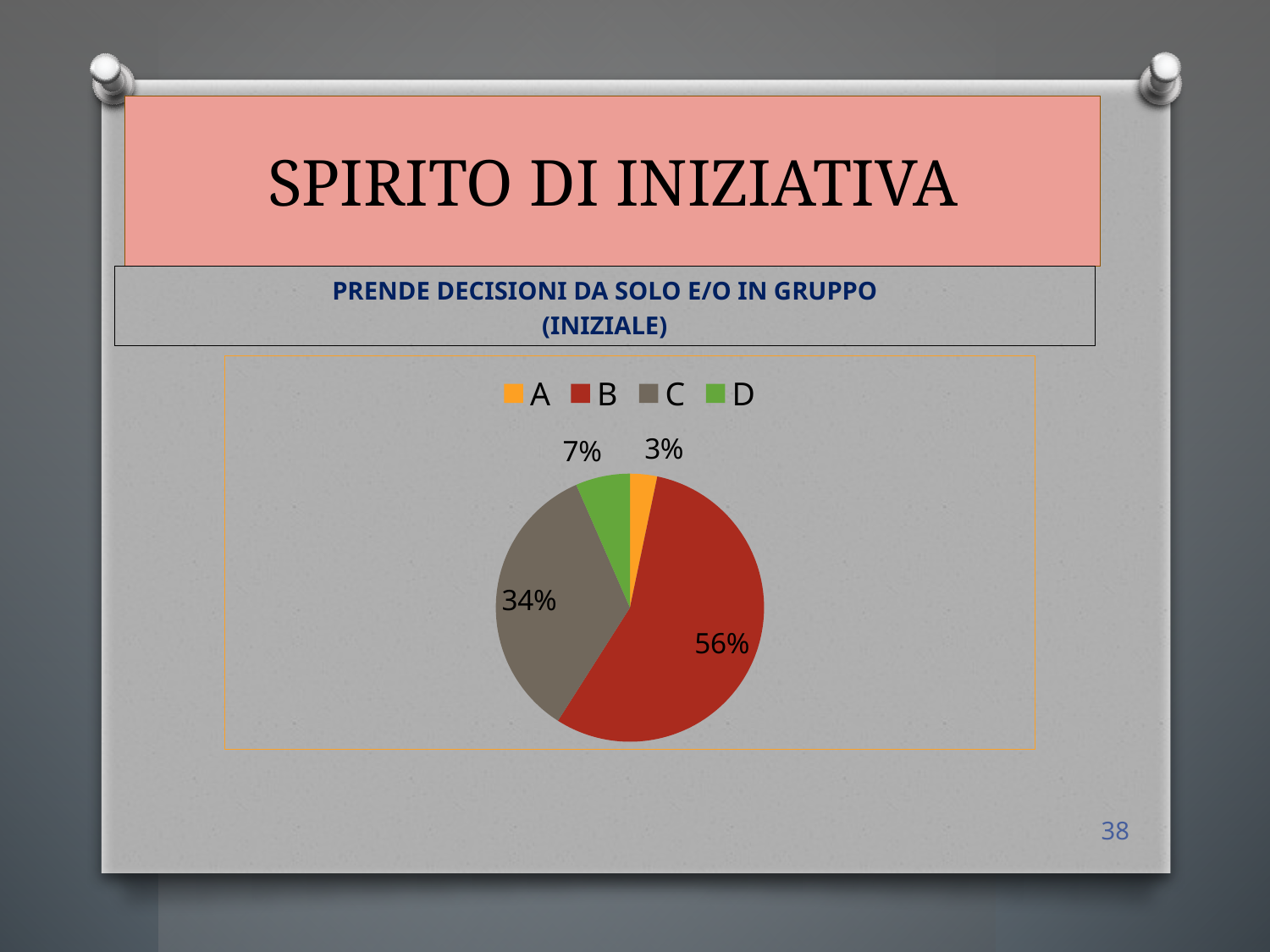
What percentage does slice A represent? 3% How many slices does the pie chart have? 4 Which category has the largest share of the pie? B How many categories does the legend list? 4 Which category has the smallest share of the pie? A Which is larger, the share for C or the share for D? C What type of chart is shown on the slide? pie chart What percentage does slice B represent? 56% What percentage does slice C represent? 34% What is the difference in percentage points between B and C? 22 What colour is the slice for category D? green What percentage does slice D represent? 7%